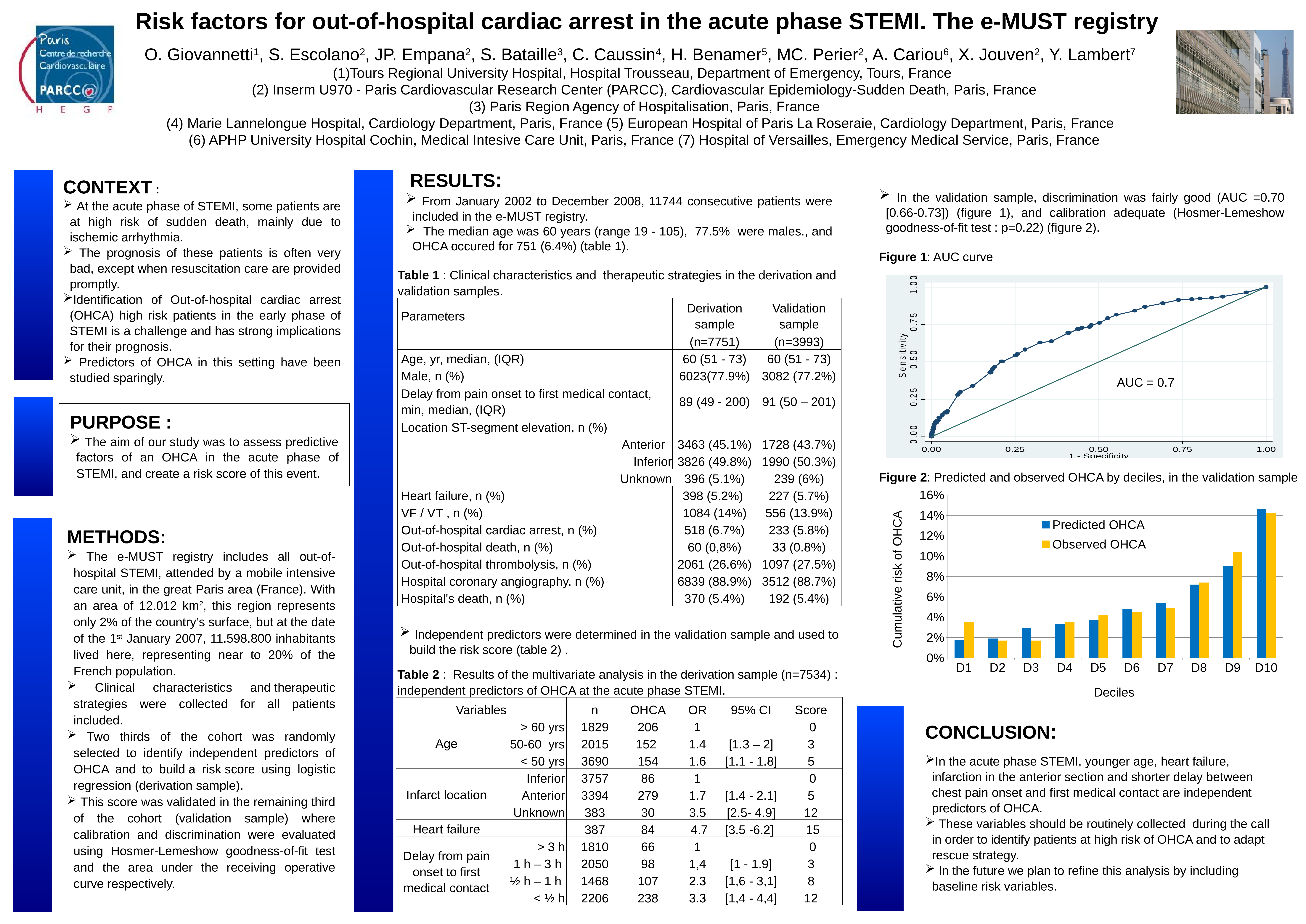
In Figure 2, is the Predicted OHCA for D10 greater or less than 14%? greater In Figure 2, which decile has the highest Predicted OHCA? D10 In Figure 1 (AUC curve), what AUC value is printed on the chart? AUC = 0.7 What is the y-axis title of Figure 2? Cumulative risk of OHCA How many deciles are shown on the x axis of Figure 2? 10 In Figure 2, does the Predicted OHCA rise or fall from D1 to D10? rise What kind of chart is Figure 2 (Predicted and observed OHCA by deciles)? bar chart In Figure 2, which decile has the highest Observed OHCA? D10 In Figure 2, for decile D3, which is larger: Predicted OHCA or Observed OHCA? Predicted OHCA How many series does the legend of Figure 2 list? 2 In Figure 2, is the Observed OHCA for D1 greater or less than 2%? greater In Figure 2, is the Predicted OHCA for D9 greater or less than 10%? less